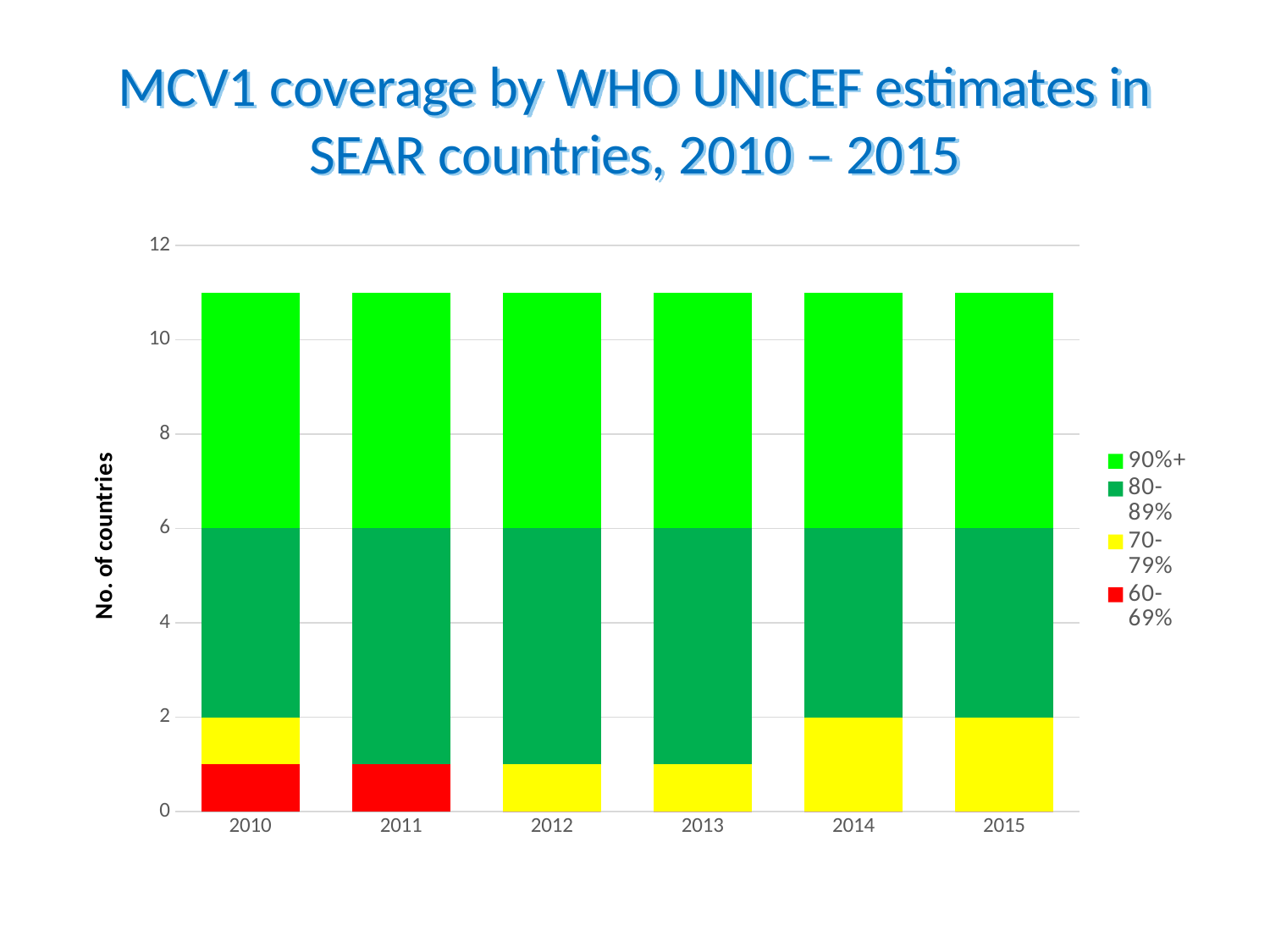
Does the total height of the bars rise, fall, or stay the same from 2010 to 2015? Stays the same Is the total number of countries for 2010 greater or less than 10? greater Which coverage category is shown in red in the legend? 60-69% How many years are shown along the x axis? 6 What kind of chart is shown on the slide? Stacked bar chart Which years have a 60-69% segment in their bar? 2010 and 2011 How many series does the legend list? 4 What is the label of the vertical axis? No. of countries Is the 70-79% segment larger in 2013 or in 2015? 2015 Is the number of countries in the 60-69% category in 2011 greater or less than 2? less Is the total number of countries for 2015 greater or less than 12? less Is the 70-79% segment larger in 2014 or in 2012? 2014